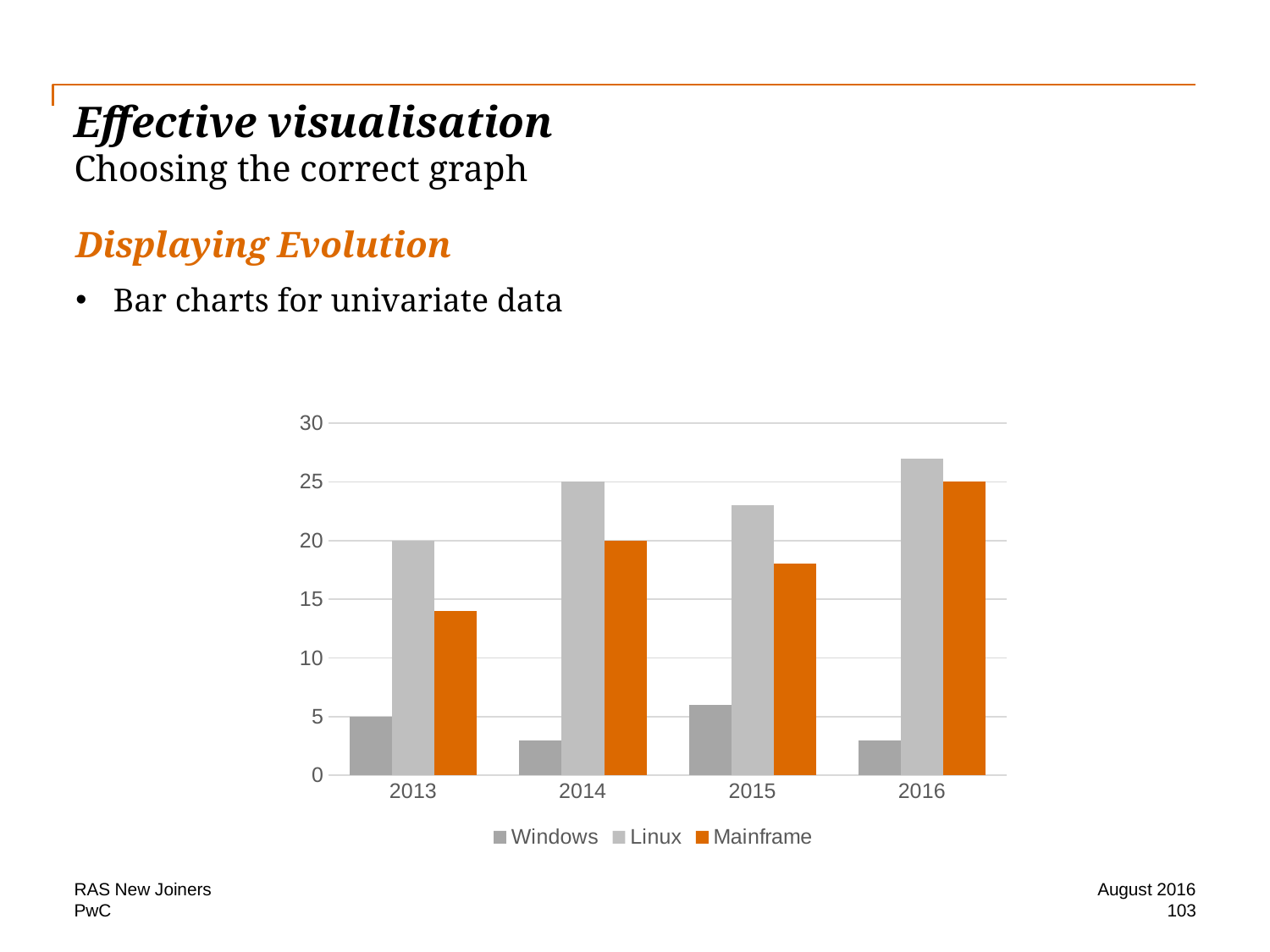
How many years are shown on the x axis? 4 Is the value for Mainframe in 2013 greater or less than 15? less Which is larger, Mainframe in 2014 or Mainframe in 2013? Mainframe in 2014 What is the value for Windows in 2013? 5 What is the value for Linux in 2013? 20 What is the value for Linux in 2014? 25 Is the value for Linux in 2016 greater or less than 25? greater Which series has the lowest value in 2016? Windows Which series has the highest value in 2015? Linux What type of chart is shown on the slide? bar chart How many series does the legend list? 3 What is the value for Mainframe in 2016? 25